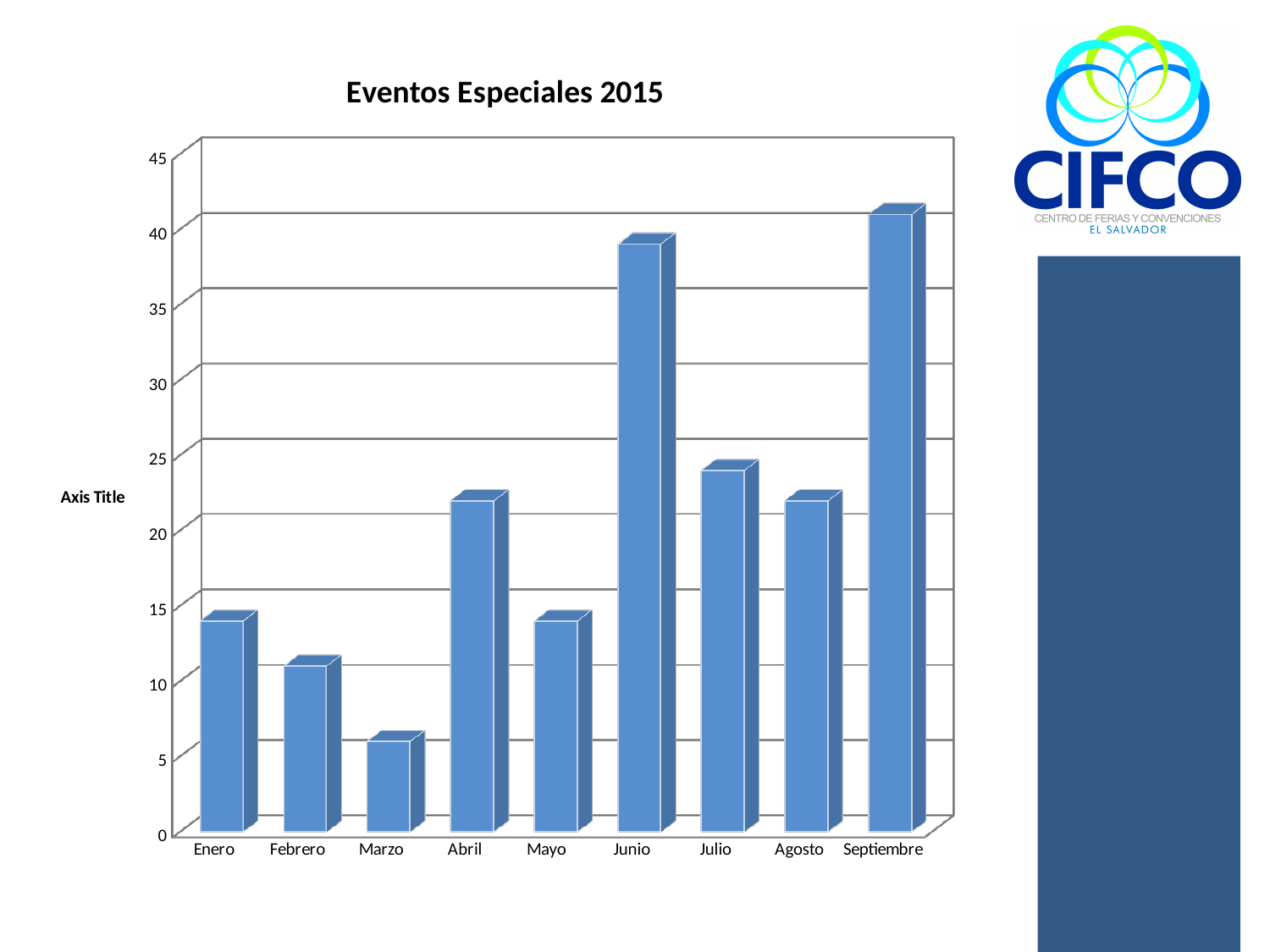
Which is larger, the value for Junio or the value for Julio? Junio What type of chart is shown on the slide? Bar chart Is the value for Abril greater or less than 20? greater Which month has the lowest value? Marzo Which month has the highest value? Septiembre How many months (categories) are shown on the x axis? 9 Is the value for Julio greater or less than 20? greater Is the value for Junio greater or less than 35? greater Which is larger, the value for Enero or the value for Febrero? Enero What is the title of the chart? Eventos Especiales 2015